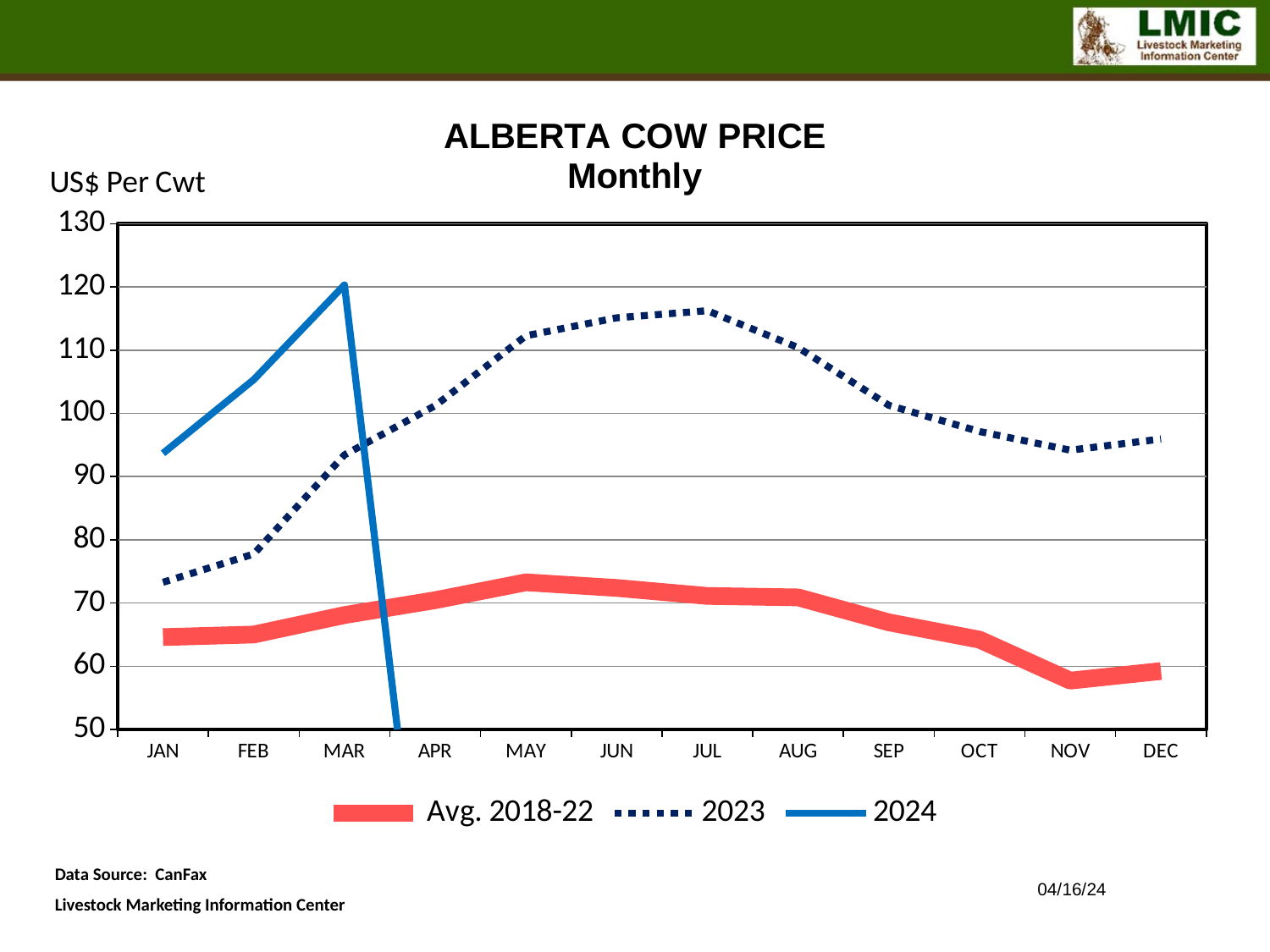
Is the Avg. 2018-22 value for NOV greater or less than 60? less Is the 2023 value for JUL greater or less than 110? greater Is the 2024 value for MAR greater or less than 110? greater Does the 2024 series rise or fall from JAN to MAR? Rise What kind of chart is shown on the slide? Line chart What unit label is shown above the y axis? US$ Per Cwt In which month is the 2023 series at its lowest? JAN How many series does the legend list? 3 In which month is the Avg. 2018-22 series at its highest? MAY In JAN, which series has the higher value, 2023 or 2024? 2024 How many months are shown along the x axis? 12